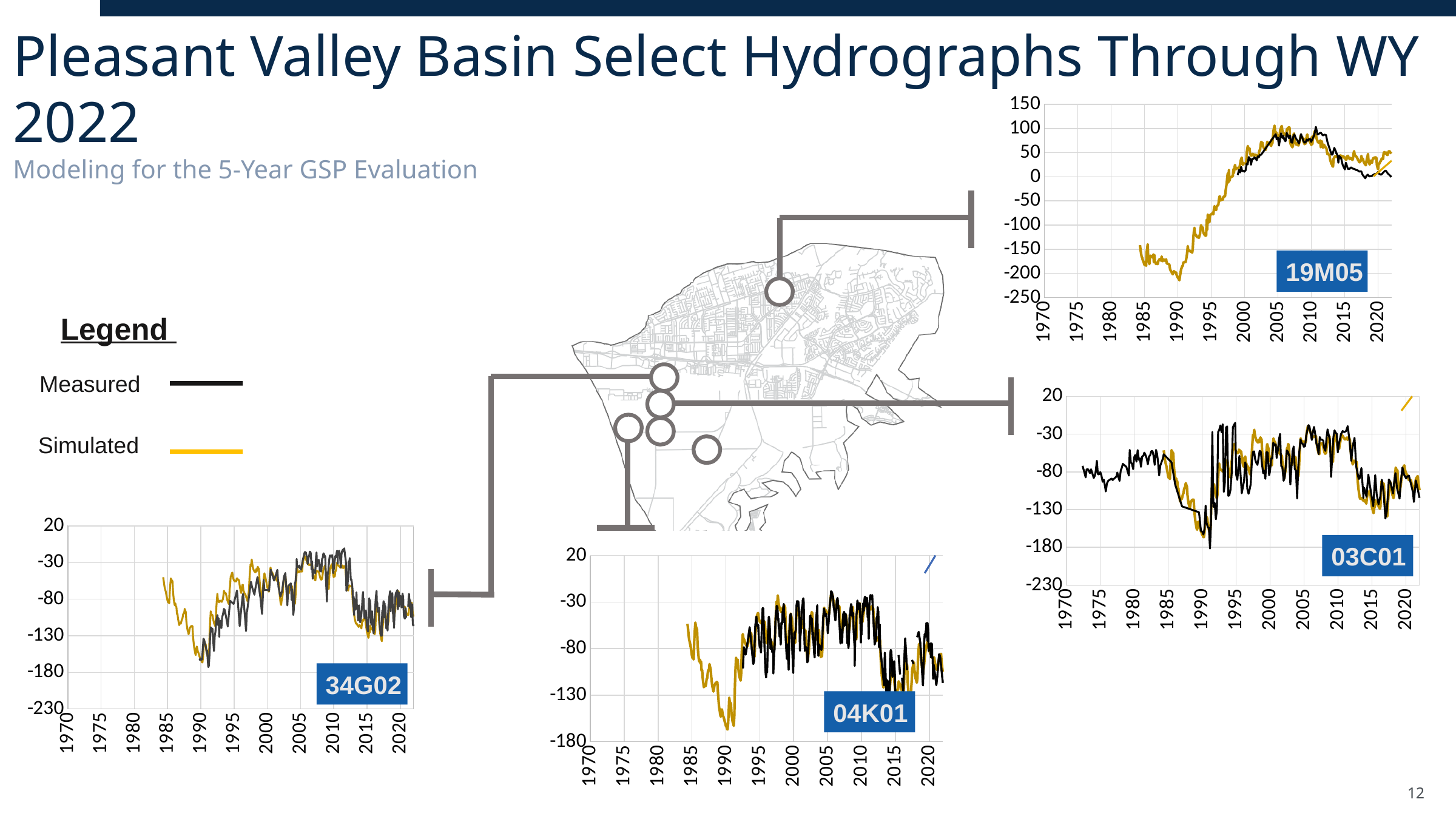
In the 19M05 chart, is the Simulated value around 1990 greater or less than -150? less According to the legend, which colour represents the Simulated series? yellow What kind of chart is the 19M05 hydrograph? line chart In the 03C01 chart, is the Measured value around 1990 greater or less than -130? less How many series does the legend list for the hydrographs? 2 Which of the four hydrograph charts reaches the highest values, 19M05 or 34G02? 19M05 In the 19M05 chart, do the values rise or fall between 1990 and 2005? rise In the 34G02 chart, is the Simulated value around 1990 greater or less than -130? less How many hydrograph charts are shown on the slide? 4 According to the legend, which colour represents the Measured series? black